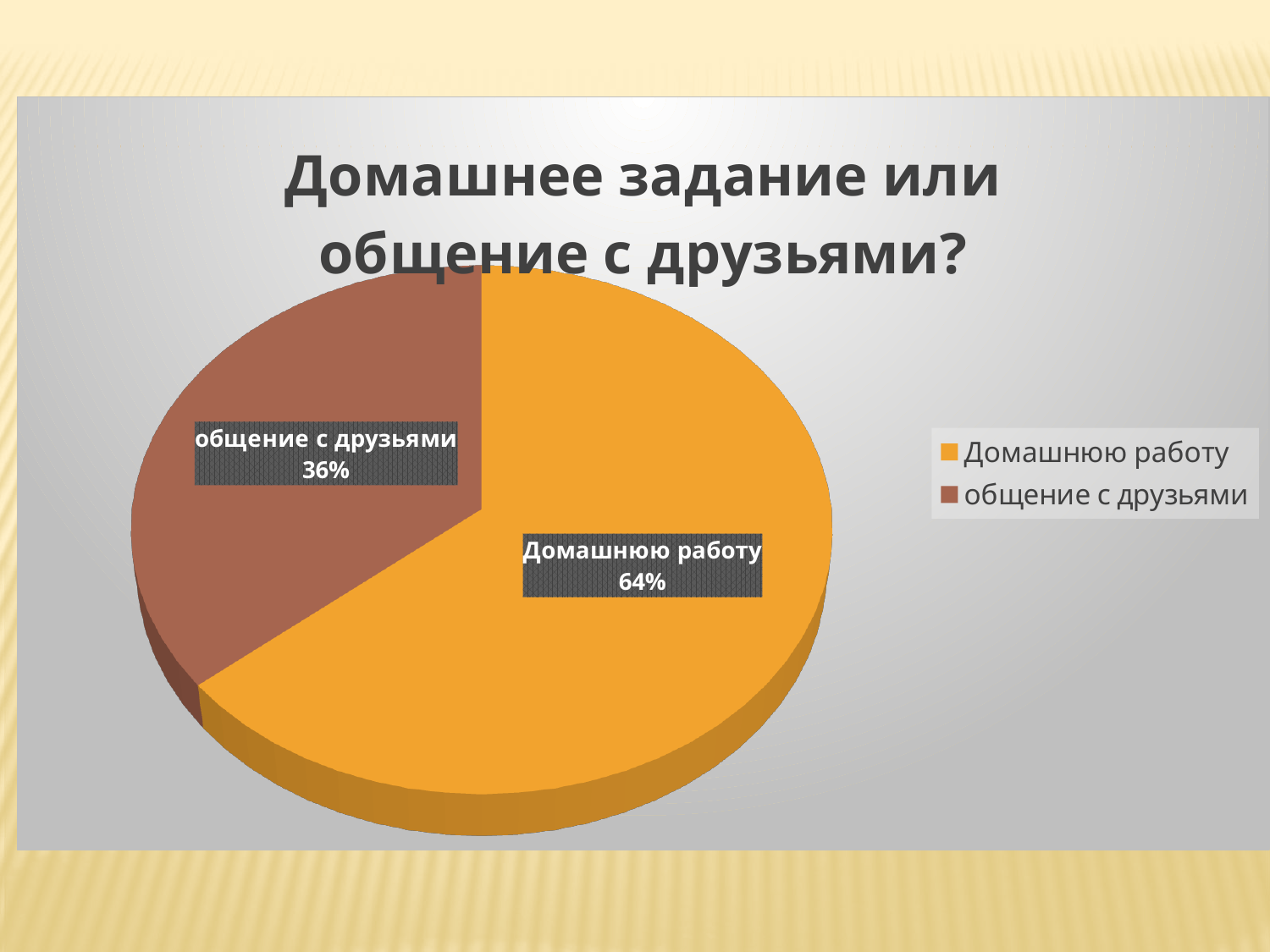
What share of the pie does общение с друзьями take? 36% What kind of chart is shown on the slide? pie chart Which slice is the smallest? общение с друзьями Which is larger, Домашнюю работу or общение с друзьями? Домашнюю работу How many entries does the legend list? 2 What percentage is shown for Домашнюю работу? 64% What percentage is shown for общение с друзьями? 36% Which slice is the largest? Домашнюю работу What is the title of the chart? Домашнее задание или общение с друзьями? How many slices does the pie chart have? 2 What colour is the Домашнюю работу slice? orange What is the difference in percentage points between Домашнюю работу and общение с друзьями? 28